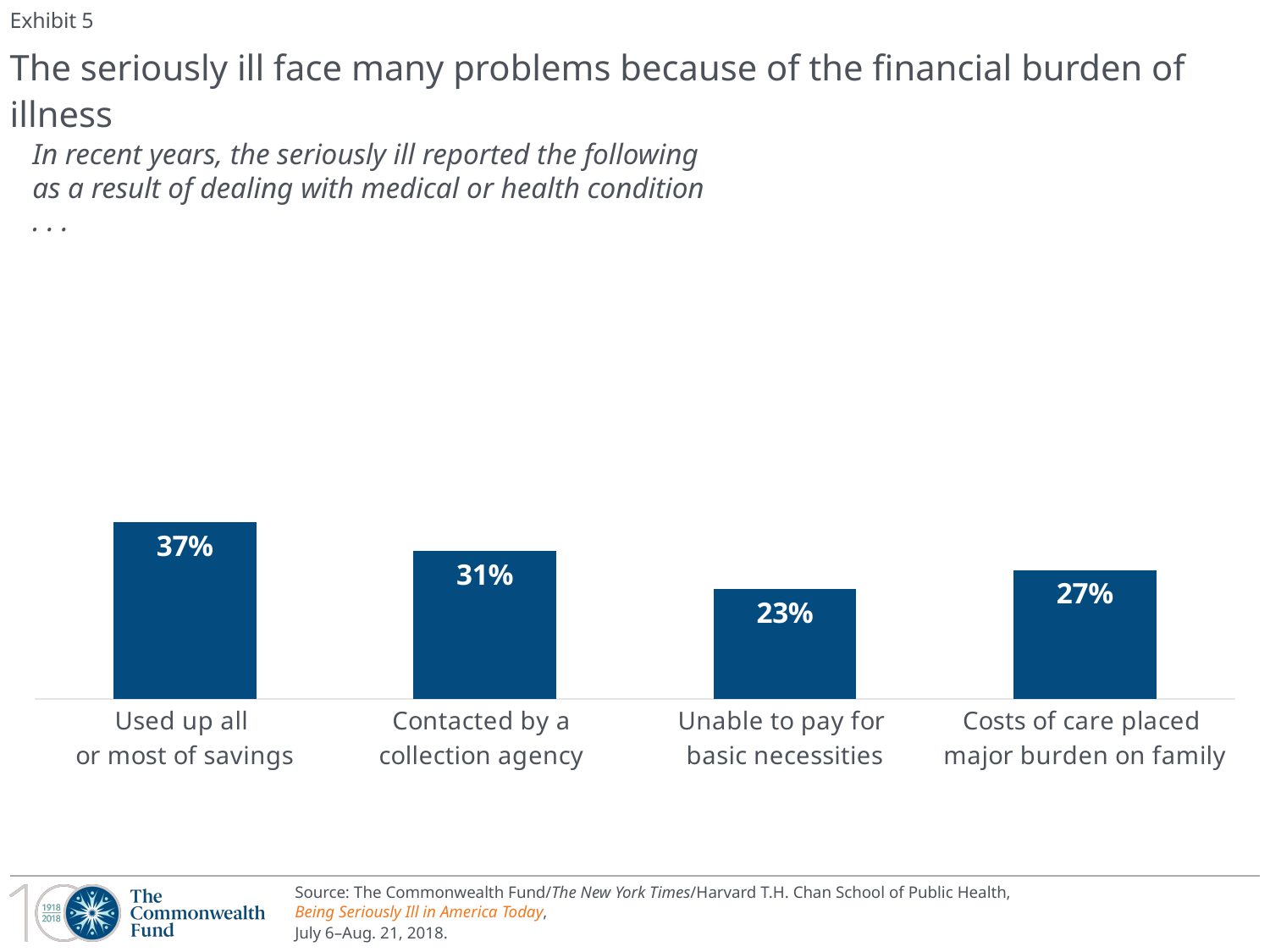
What is the exhibit number shown on the slide? Exhibit 5 What is the difference between the share who used up all or most of savings and the share unable to pay for basic necessities? 14 percentage points What percentage of the seriously ill reported having used up all or most of their savings? 37% What kind of chart is shown on the slide? Bar chart What percentage reported that costs of care placed a major burden on family? 27% Which is larger: the share contacted by a collection agency or the share reporting costs of care placed a major burden on family? Contacted by a collection agency What is the difference between the share contacted by a collection agency and the share reporting costs of care placed a major burden on family? 4 percentage points How many categories are shown in the chart? 4 What percentage reported being unable to pay for basic necessities? 23% Which category has the lowest value? Unable to pay for basic necessities What percentage reported being contacted by a collection agency? 31% Which category has the highest value? Used up all or most of savings